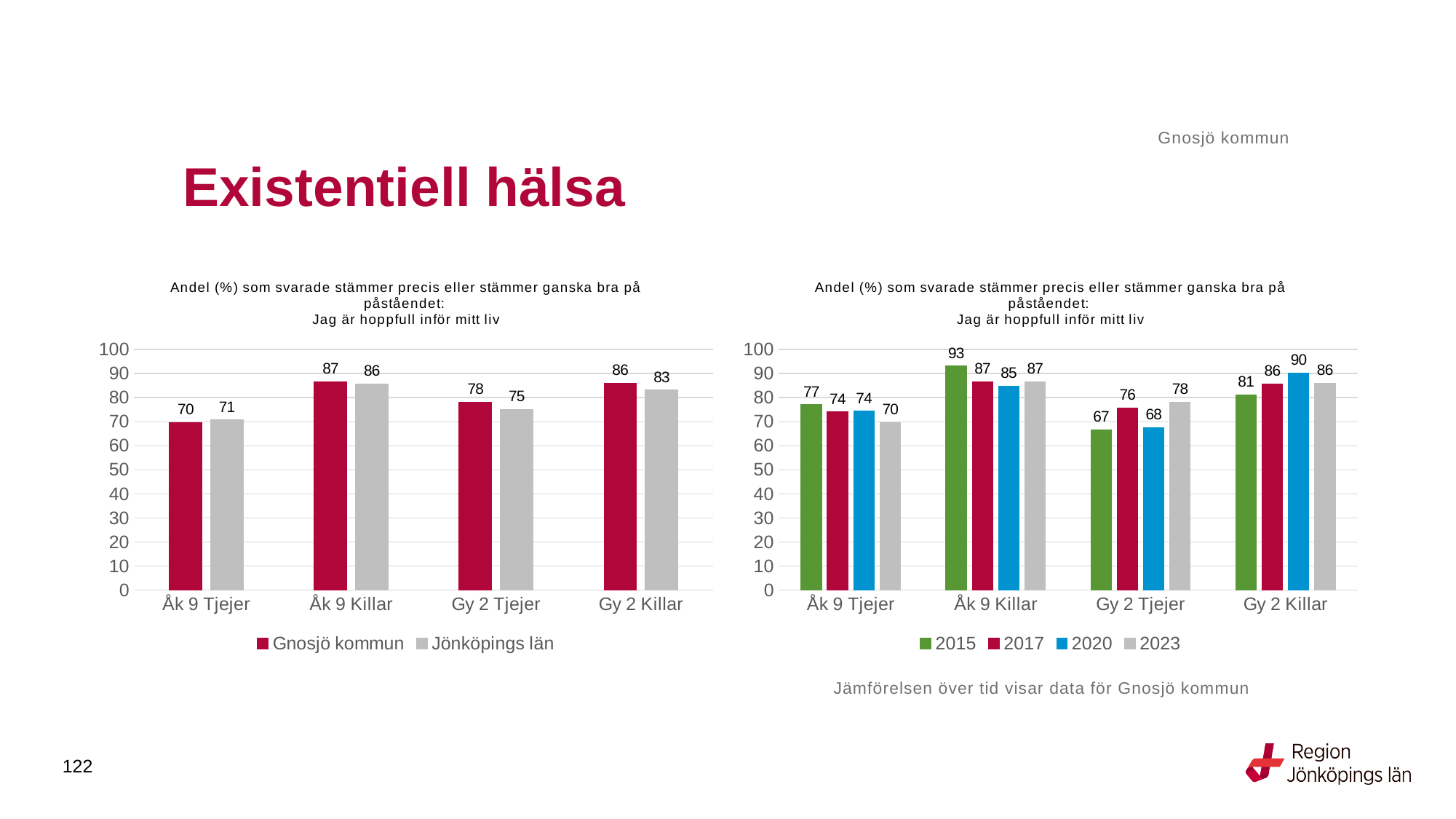
In the right chart, how many series does the legend list? 4 In the right chart, what is the value for 2020 for Gy 2 Killar? 90 What kind of chart is the right chart? Bar chart In the right chart, what is the difference between the 2023 and 2020 values for Gy 2 Tjejer? 10 In the left chart, what is the difference between Gnosjö kommun and Jönköpings län for Gy 2 Killar? 3 In the right chart, what is the value for 2015 for Åk 9 Killar? 93 In the right chart, which is larger for Åk 9 Tjejer: 2015 or 2023? 2015 In the left chart, which category has the lowest value for Gnosjö kommun? Åk 9 Tjejer In the left chart, how many series does the legend list? 2 In the left chart, what is the value for Gnosjö kommun for Åk 9 Killar? 87 In the right chart, which year has the lowest value for Gy 2 Tjejer? 2015 In the left chart, what is the value for Jönköpings län for Gy 2 Tjejer? 75